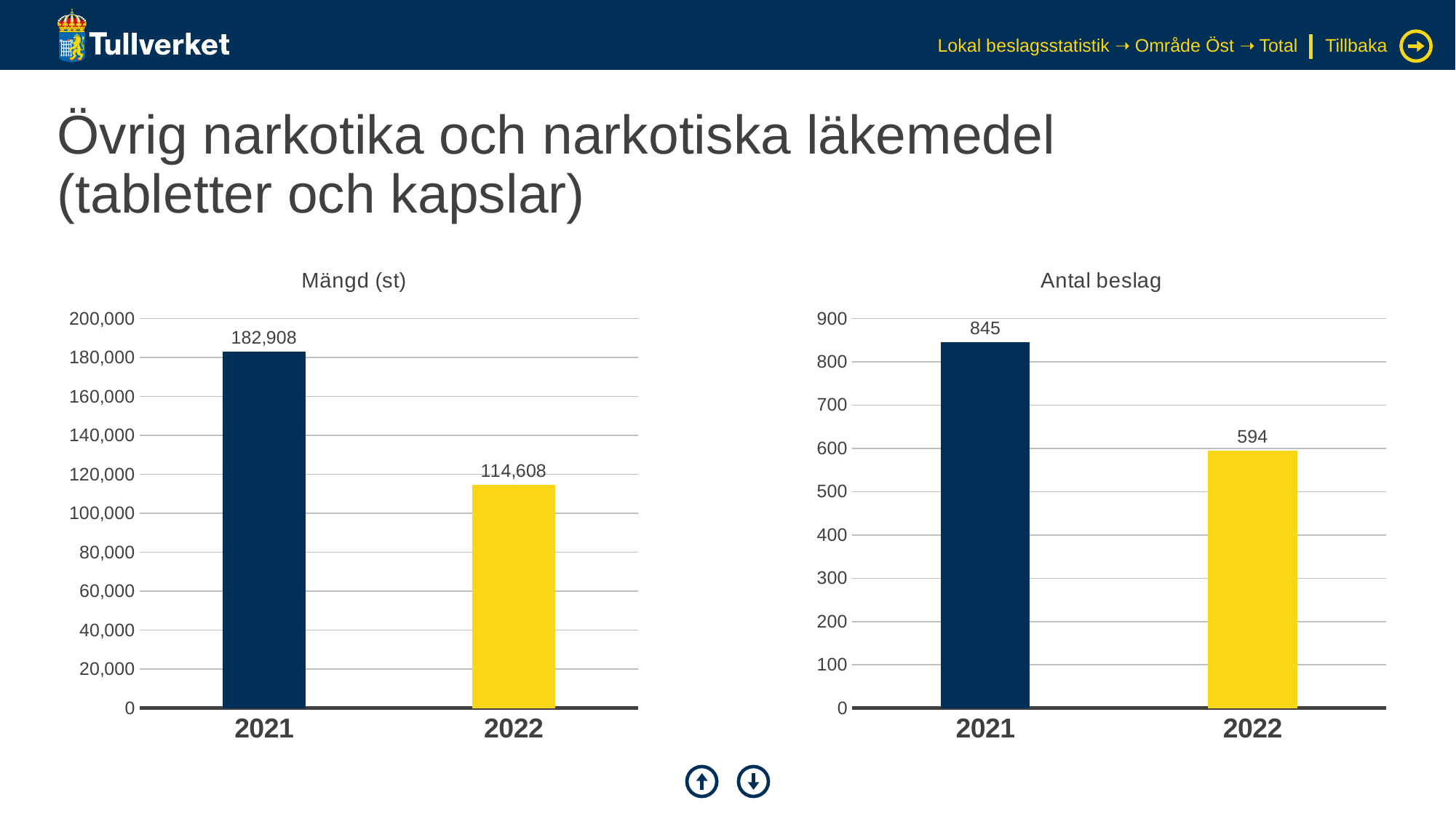
In the 'Antal beslag' chart, is the value for 2022 greater or less than 500? greater In the 'Mängd (st)' chart, do the values rise or fall from 2021 to 2022? fall In the 'Antal beslag' chart, what is the difference between the 2021 and 2022 values? 251 In the 'Mängd (st)' chart, what is the value for 2021? 182,908 How many categories are shown on the x axis of the 'Antal beslag' chart? 2 In the 'Antal beslag' chart, what is the value for 2021? 845 In the 'Mängd (st)' chart, what is the difference between the 2021 and 2022 values? 68,300 What kind of chart is the 'Mängd (st)' chart? bar chart In the 'Antal beslag' chart, what is the value for 2022? 594 In the 'Mängd (st)' chart, which year has the highest value? 2021 In the 'Antal beslag' chart, which year has the lowest value? 2022 In the 'Mängd (st)' chart, what is the value for 2022? 114,608